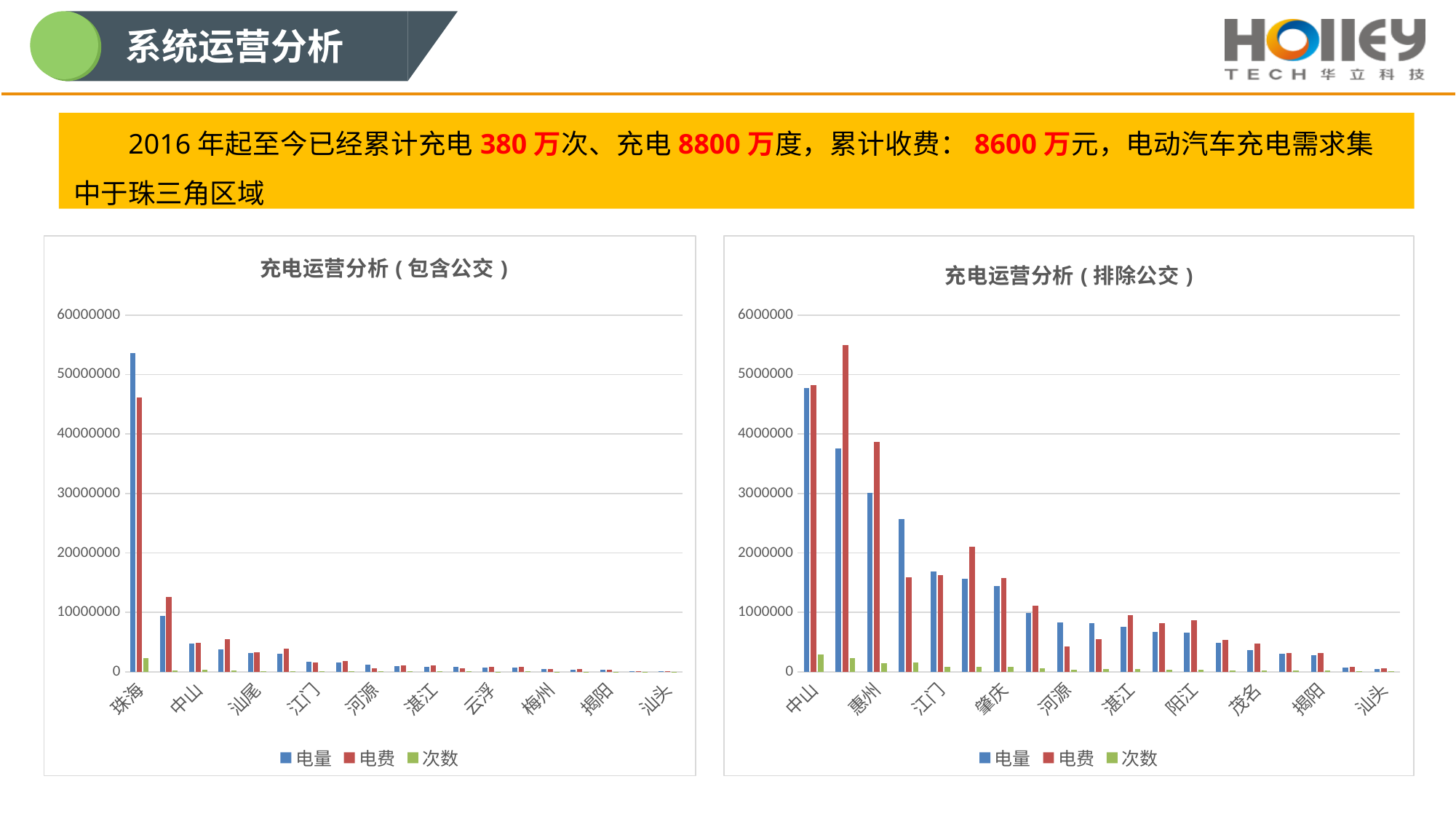
In the left chart 充电运营分析（包含公交）, which category has the highest 电量 value? 珠海 In the right chart 充电运营分析（排除公交）, is the 电量 value for 江门 greater or less than 2000000? less In the left chart 充电运营分析（包含公交）, how many categories are shown on the x axis? 19 In the right chart 充电运营分析（排除公交）, which category has the highest 电量 value? 中山 In the left chart 充电运营分析（包含公交）, is the 电费 value for 中山 greater or less than 10000000? less In the right chart 充电运营分析（排除公交）, is the 电费 value for 惠州 greater or less than 5000000? less In the right chart 充电运营分析（排除公交）, do the 电量 values generally rise or fall from left to right along the x axis? fall In the right chart 充电运营分析（排除公交）, how many series does the legend list? 3 What type of chart is the left chart titled 充电运营分析（包含公交）? bar chart In the right chart 充电运营分析（排除公交）, which is larger: the 电量 value for 中山 or the 电量 value for 惠州? 中山